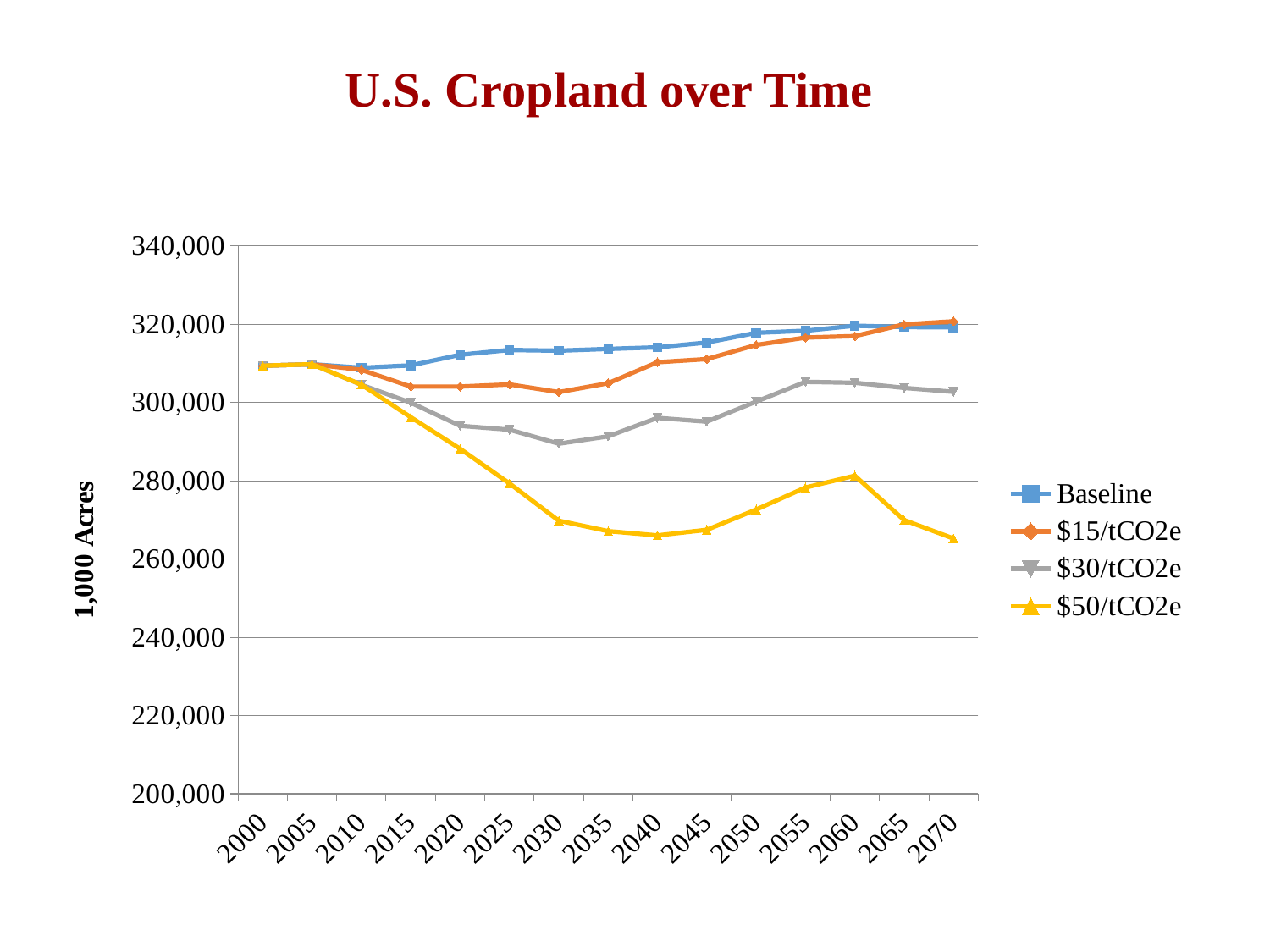
Which is larger in 2050, the $15/tCO2e value or the $30/tCO2e value? $15/tCO2e How many years are plotted along the x axis? 15 Which series has the lowest value in 2040? $50/tCO2e Does the $50/tCO2e series rise or fall from 2005 to 2040? fall Which series has the lowest value in 2070? $50/tCO2e How many series does the legend list? 4 What is the label on the y axis? 1,000 Acres Is the value for $30/tCO2e in 2030 greater or less than 300,000? less What is the title of the chart? U.S. Cropland over Time What kind of chart is shown on the slide? line chart Is the value for Baseline in 2050 greater or less than 300,000? greater Is the value for $50/tCO2e in 2040 greater or less than 280,000? less